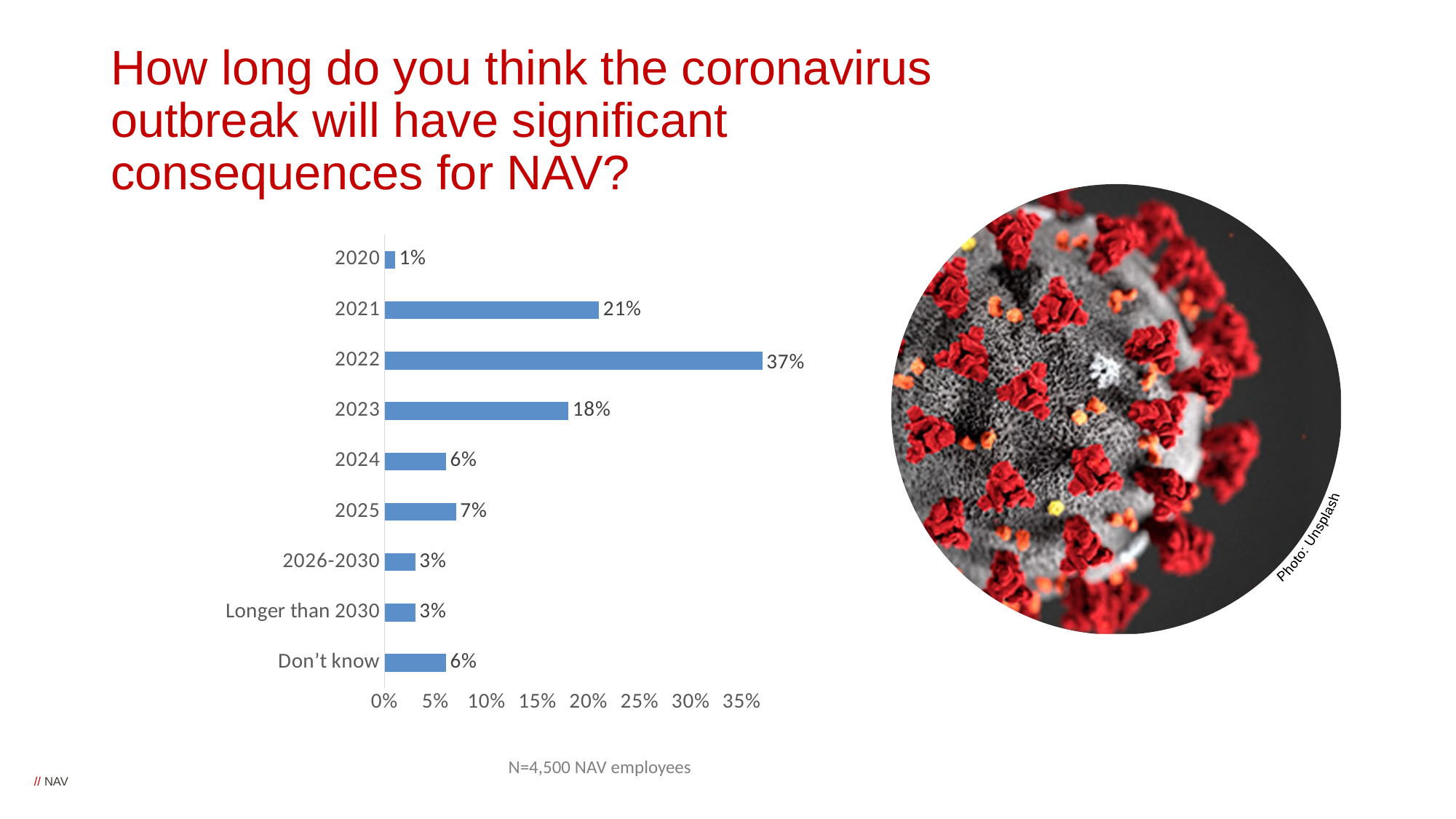
What is the value for 2021? 21% What is the difference between the values for 2022 and 2023? 19% What is the value for 'Longer than 2030'? 3% Which category has the lowest value? 2020 What percentage of respondents answered 'Don't know'? 6% How many categories are shown on the chart? 9 According to the note below the chart, how many NAV employees were surveyed? 4,500 What is the combined value for 2024 and 2025? 13% Which is larger, the value for 2021 or the value for 2023? 2021 Which category has the highest value? 2022 What percentage of respondents chose 2022? 37% What kind of chart is shown on the slide? Bar chart